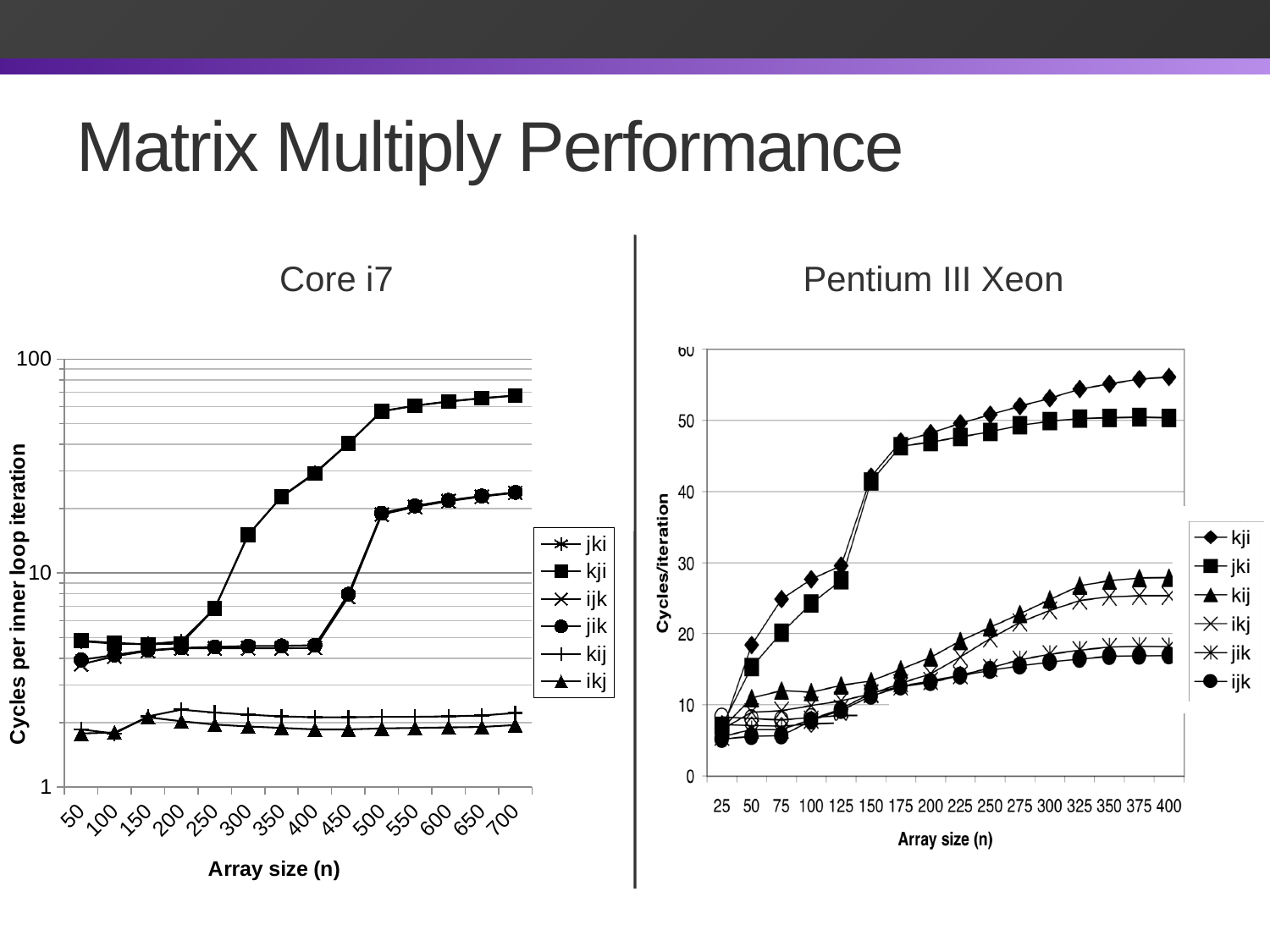
On the Pentium III Xeon chart, how many array sizes are marked along the x axis? 16 On the Core i7 chart, does the kji series rise or fall as array size increases? rise On the Core i7 chart, how many array sizes are marked along the x axis? 14 On the Core i7 chart, is the value for kji at array size 700 greater or less than 10? greater On the Core i7 chart, is the value for ikj at array size 700 greater or less than 10? less On the Pentium III Xeon chart, how many series does the legend list? 6 What kind of chart is the Core i7 chart? line chart On the Pentium III Xeon chart, is the value for kji at array size 400 greater or less than 50? greater On the Pentium III Xeon chart, which series has the highest value at array size 400? kji On the Core i7 chart, how many series does the legend list? 6 What is the y-axis label of the Core i7 chart? Cycles per inner loop iteration